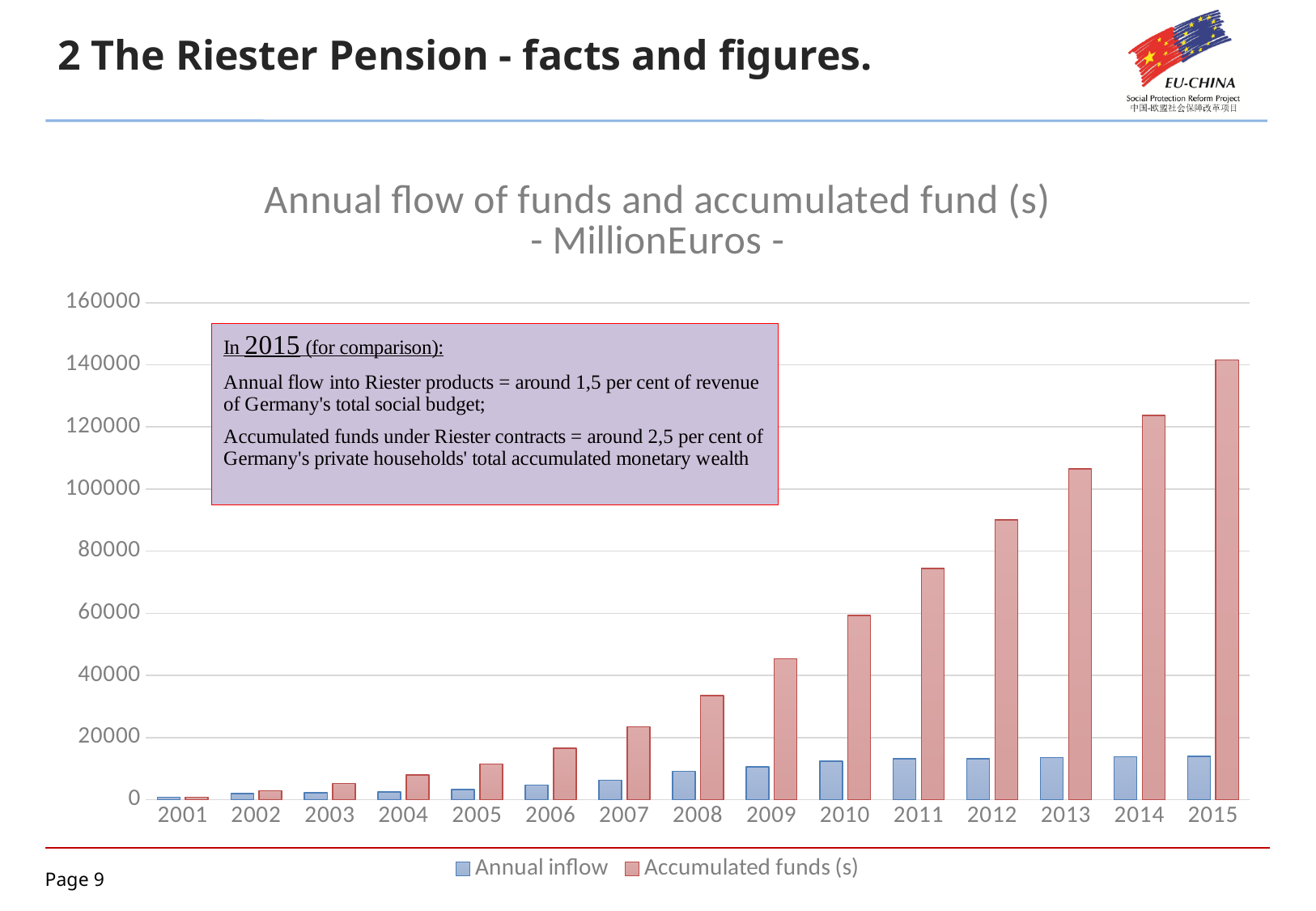
Do the values for Accumulated funds (s) rise or fall from 2001 to 2015? rise Which year has the larger value for Accumulated funds (s): 2013 or 2014? 2014 Is the value for Accumulated funds (s) in 2008 greater or less than 40000? less In which year is the value for Accumulated funds (s) highest? 2015 Which colour represents Annual inflow in the legend? blue Is the value for Annual inflow in 2015 greater or less than 20000? less In which year is the value for Accumulated funds (s) lowest? 2001 Which is larger in 2009: Annual inflow or Accumulated funds (s)? Accumulated funds (s) How many series does the legend list? 2 Is the value for Accumulated funds (s) in 2015 greater or less than 120000? greater How many years are shown along the x axis? 15 What kind of chart is shown on the slide? bar chart